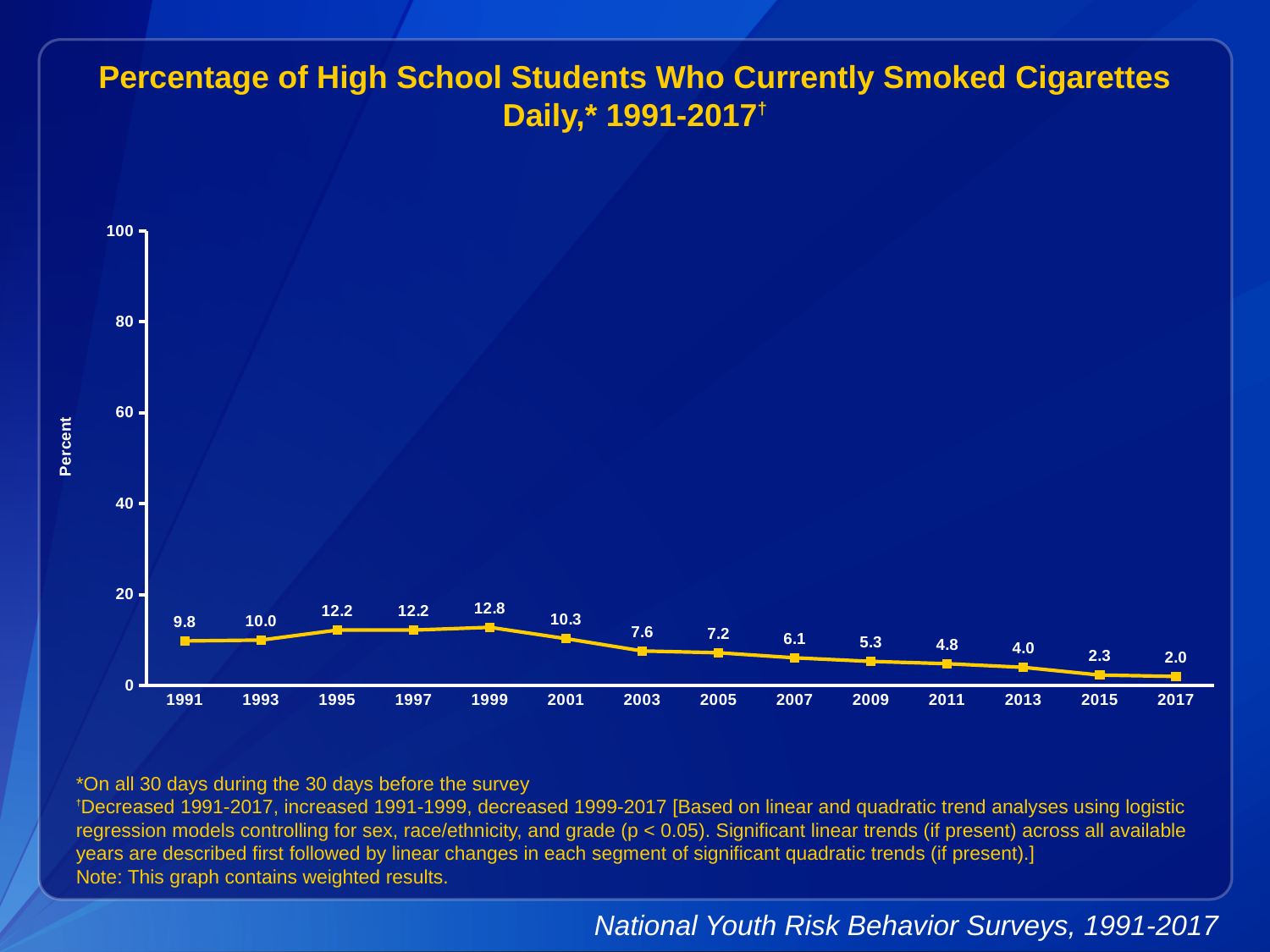
Which is larger, the value for 1991 or the value for 2001? 2001 How many years are plotted on the x axis? 14 Which year has the highest value? 1999 What is the difference between the values for 1999 and 2017? 10.8 Which year has the lowest value? 2017 What is the value for 1999? 12.8 What is the label on the y axis? Percent What is the value for 2017? 2.0 Is the value for 1995 greater or less than 20? less What is the value for 2007? 6.1 What kind of chart is shown? line chart Do the values rise or fall from 1999 to 2017? fall